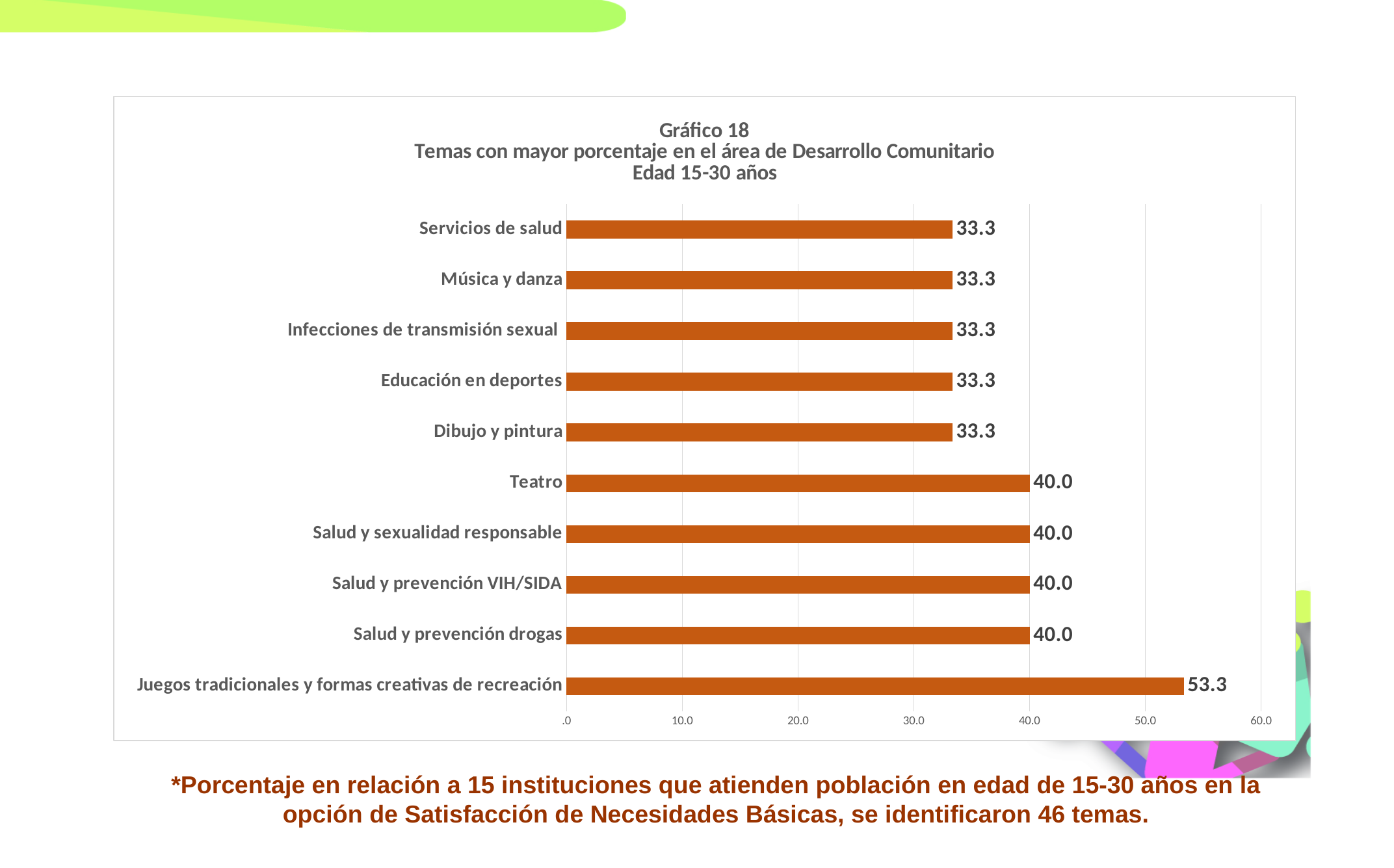
How many categories are shown in the chart? 10 What is the chart number given in the title? Gráfico 18 What is the difference between the values for Salud y prevención VIH/SIDA and Dibujo y pintura? 6.7 What kind of chart is this? bar chart Is the value for Juegos tradicionales y formas creativas de recreación greater or less than 50.0? greater What is the difference between the values for Juegos tradicionales y formas creativas de recreación and Teatro? 13.3 Which is larger, the value for Teatro or the value for Música y danza? Teatro What is the value for Teatro? 40.0 What is the value for Juegos tradicionales y formas creativas de recreación? 53.3 Which category has the highest value? Juegos tradicionales y formas creativas de recreación What is the value for Salud y prevención drogas? 40.0 What is the value for Servicios de salud? 33.3